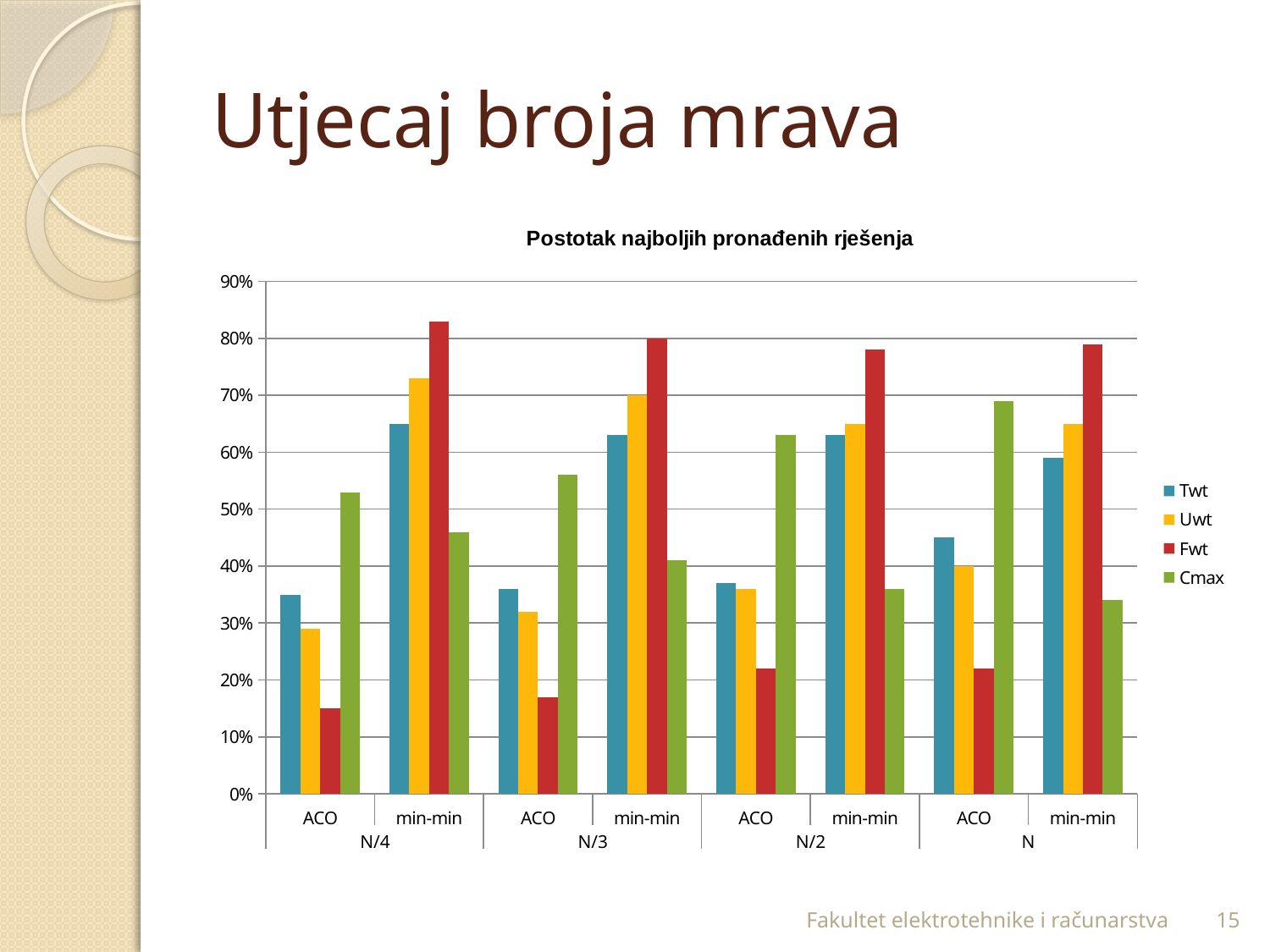
Which series has the lowest value in the ACO group under N/3? Fwt What is the title of the chart? Postotak najboljih pronađenih rješenja Is the value for Cmax in the ACO group under N greater or less than 60%? greater What kind of chart is shown on the slide? bar chart Which series has the highest value in the min-min group under N/4? Fwt Is the value for Cmax in the min-min group under N greater or less than 40%? less In the ACO group under N/2, which is larger: Cmax or Twt? Cmax Which series is shown in green in the legend? Cmax How many category groups (ACO/min-min pairs) are shown along the x axis? 4 Is the value for Fwt in the ACO group under N/4 greater or less than 20%? less How many series does the legend list? 4